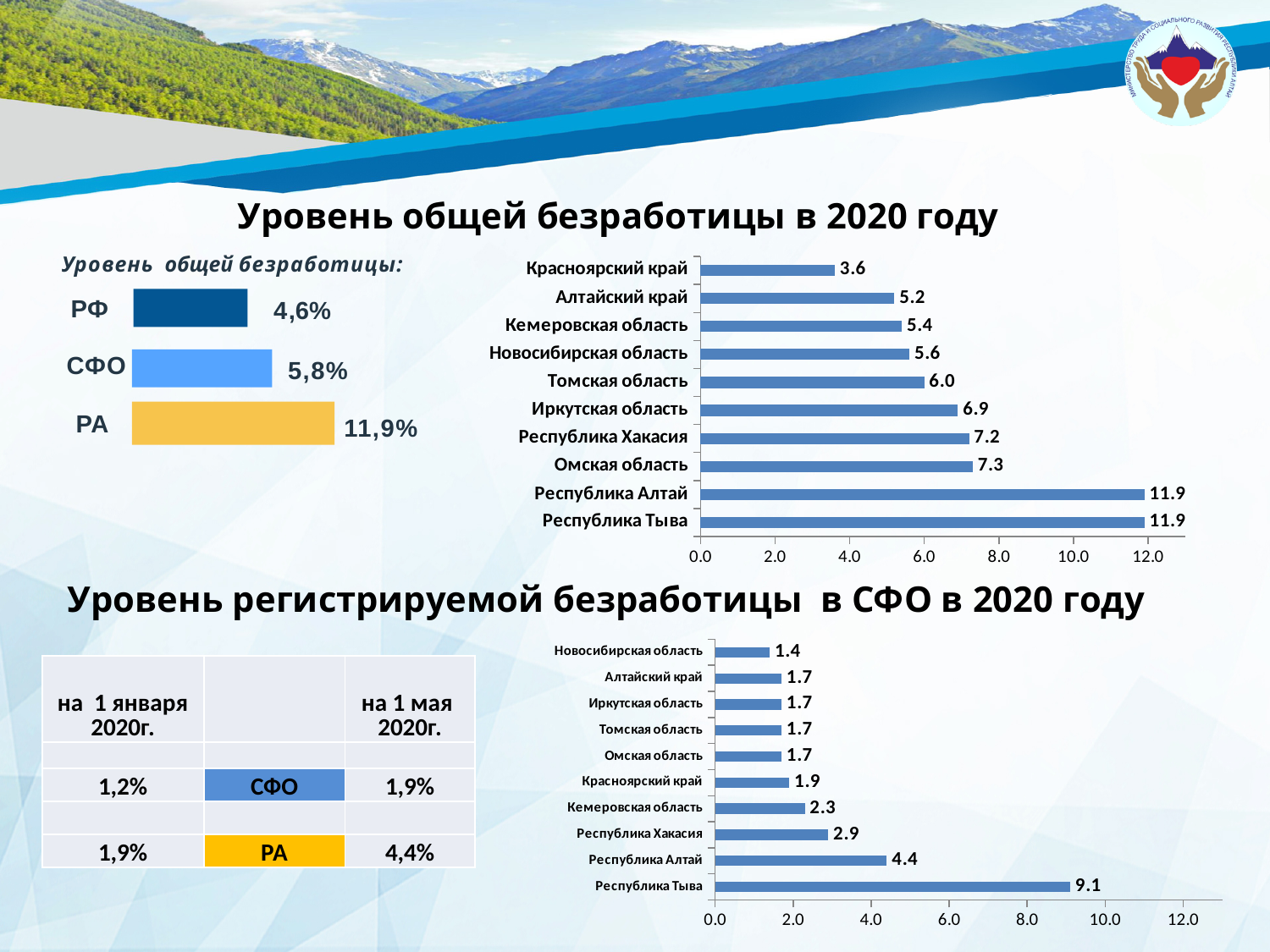
In the top chart 'Уровень общей безработицы в 2020 году', which region has the lowest value? Красноярский край In the top chart 'Уровень общей безработицы в 2020 году', what is the value for Омская область? 7.3 In the bottom chart 'Уровень регистрируемой безработицы в СФО в 2020 году', what is the difference between Республика Алтай and Красноярский край? 2.5 In the top chart 'Уровень общей безработицы в 2020 году', how many regions are plotted? 10 In the bottom chart 'Уровень регистрируемой безработицы в СФО в 2020 году', what is the value for Республика Тыва? 9.1 In the bottom chart 'Уровень регистрируемой безработицы в СФО в 2020 году', which region has the highest value? Республика Тыва In the small chart on the left titled 'Уровень общей безработицы:', what is the value for СФО? 5,8% What kind of chart is the bottom chart 'Уровень регистрируемой безработицы в СФО в 2020 году'? Bar chart In the top chart 'Уровень общей безработицы в 2020 году', what is the difference between Республика Алтай and Томская область? 5.9 In the bottom chart 'Уровень регистрируемой безработицы в СФО в 2020 году', which is larger: Республика Хакасия or Кемеровская область? Республика Хакасия In the bottom chart 'Уровень регистрируемой безработицы в СФО в 2020 году', which region has the lowest value? Новосибирская область In the top chart 'Уровень общей безработицы в 2020 году', what is the value for Красноярский край? 3.6